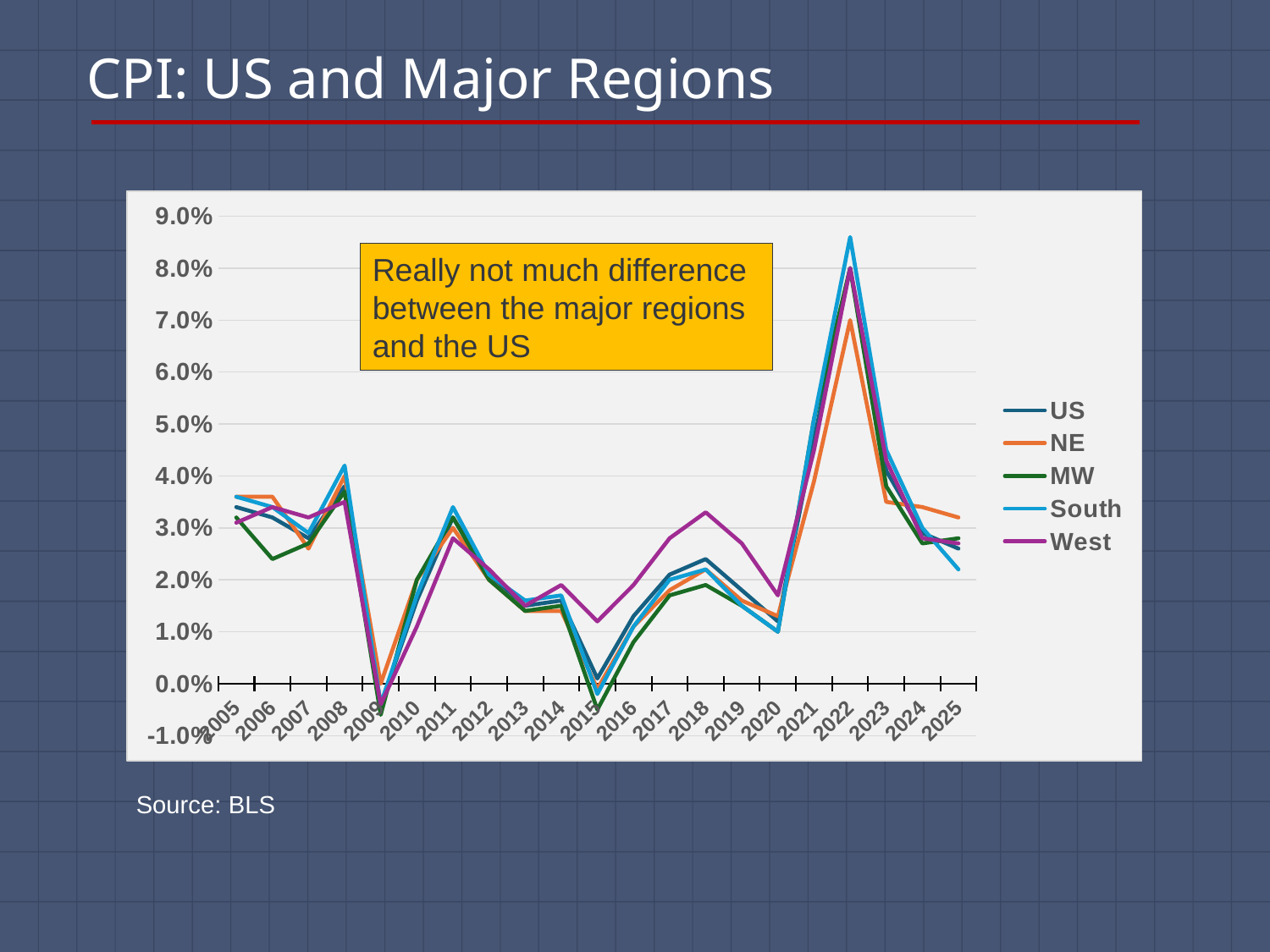
What kind of chart is shown on the slide? line chart How many series does the legend list? 5 Does the South series rise or fall from 2022 to 2025? fall Which series has the highest value in 2018? West How many years are plotted along the x axis? 21 Is the value for MW in 2015 greater or less than 0.0%? less What is the title of the chart on the slide? CPI: US and Major Regions Which series has the lowest value in 2022? NE Which series has the lowest value in 2015? MW Which series has the highest value in 2022? South In which year does the South series reach its highest value? 2022 Is the value for South in 2022 greater or less than 8.0%? greater